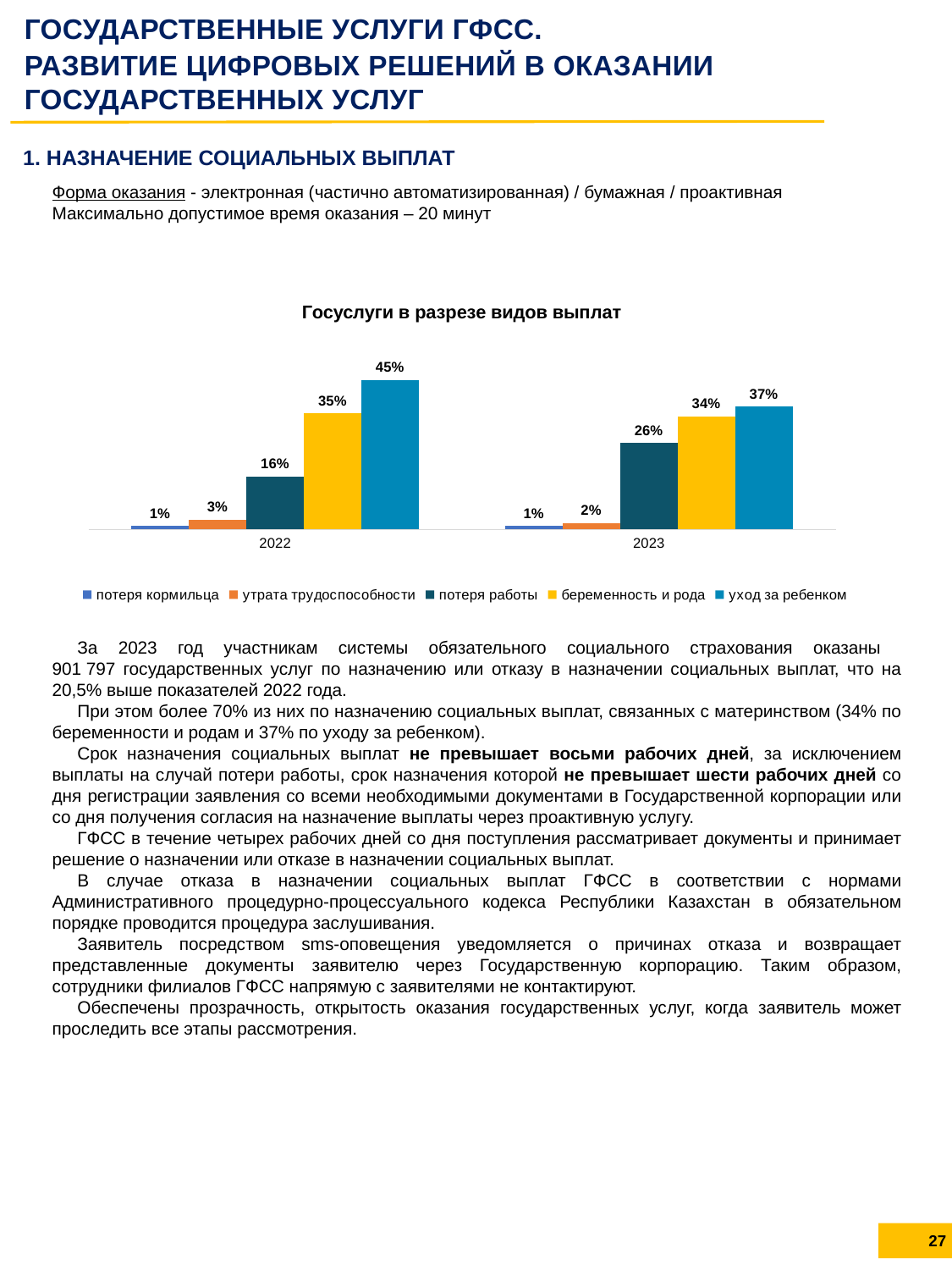
What is the value for 'уход за ребенком' in 2022? 45% What is the value for 'потеря работы' in 2023? 26% What is the difference between the 'потеря работы' values for 2023 and 2022? 10% Which series has the highest value in 2023? уход за ребенком What type of chart is shown on the slide? bar chart How many series does the chart legend list? 5 Does the value for 'уход за ребенком' rise or fall from 2022 to 2023? fall How many year categories are shown on the x axis of the chart? 2 What is the value for 'беременность и рода' in 2022? 35% Which series has the lowest value in 2022? потеря кормильца What is the title of the chart on the slide? Госуслуги в разрезе видов выплат Which is larger: 'уход за ребенком' in 2022 or 'уход за ребенком' in 2023? 2022